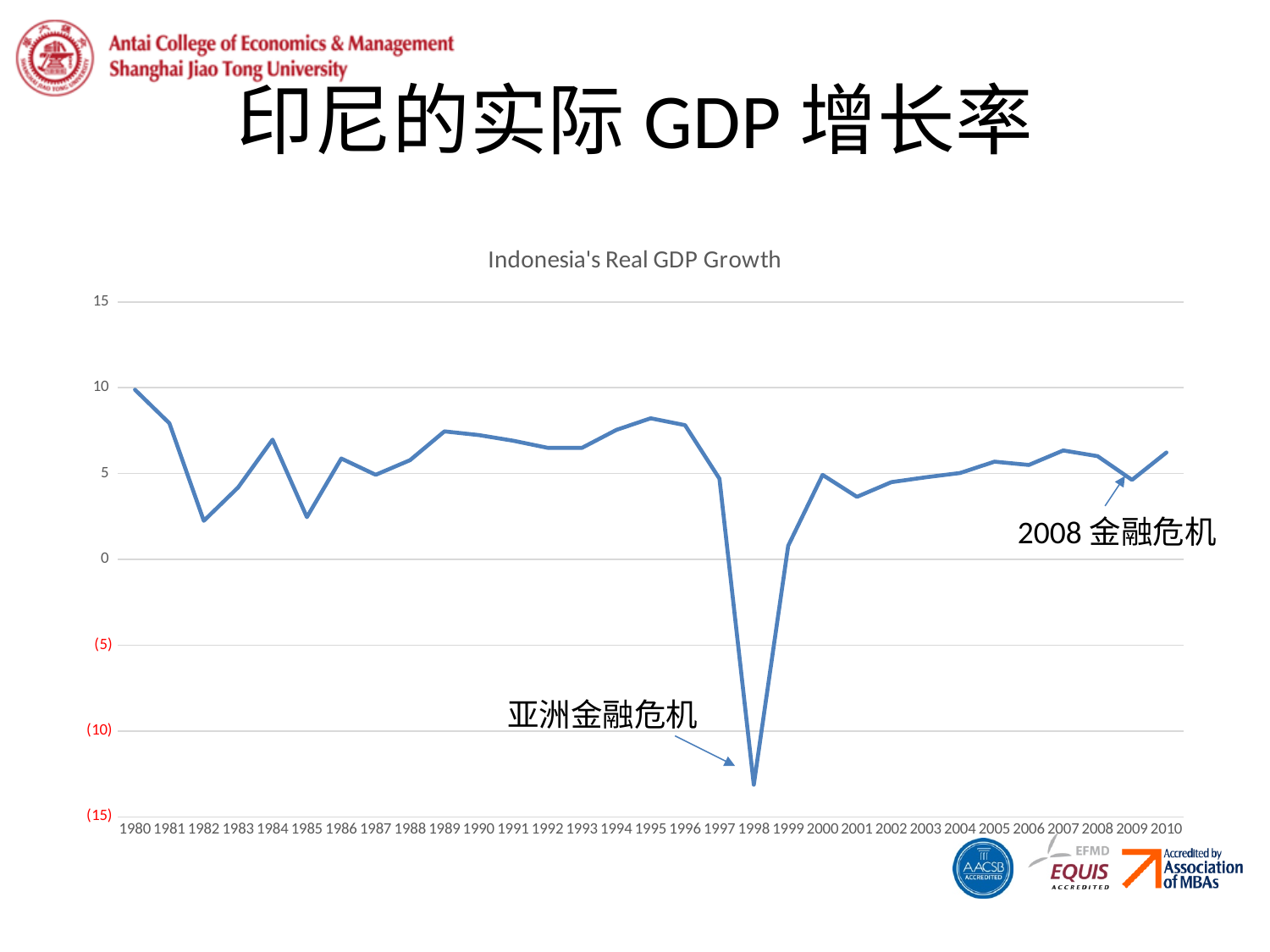
What is the title of the chart? Indonesia's Real GDP Growth Is the value for 1998 greater or less than (10)? less Which year has the highest real GDP growth in the chart? 1980 Which year has the larger value, 1998 or 1999? 1999 Which year has the lowest real GDP growth in the chart? 1998 How many years are plotted on the x axis of the chart? 31 Do the values rise or fall from 1980 to 1982? fall Is the value for 1982 greater or less than 5? less Is the value for 1995 greater or less than 5? greater What kind of chart is shown on the slide? line chart Which event does the annotation pointing at the 1998 dip label? 亚洲金融危机